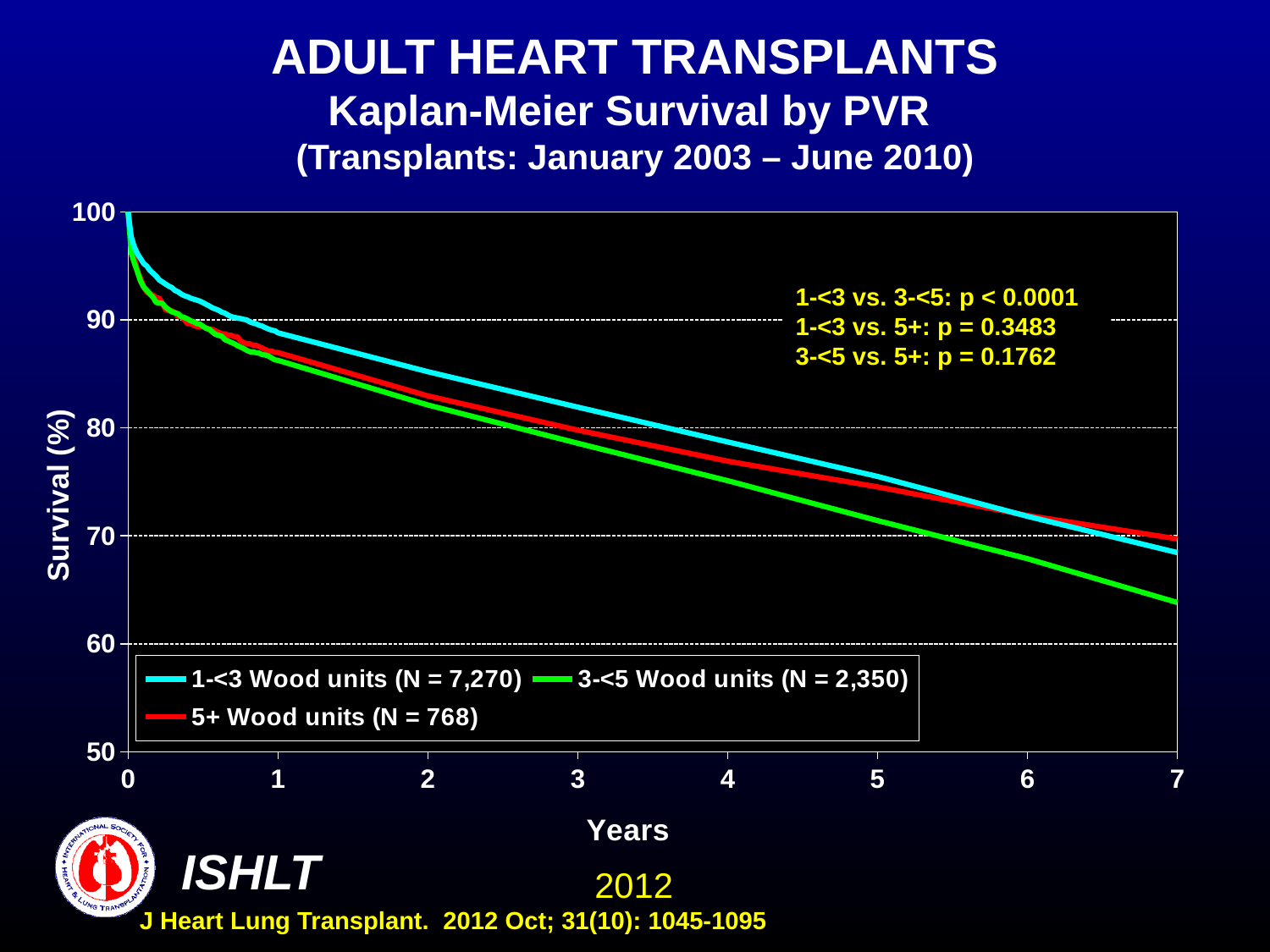
Which series has the lowest survival at 7 years? 3-<5 Wood units Is the survival for 3-<5 Wood units at 7 years greater or less than 70? less At 7 years, is survival higher for 1-<3 Wood units or 3-<5 Wood units? 1-<3 Wood units Do the survival curves rise or fall as years increase? fall What is the N for the 5+ Wood units group shown in the legend? 768 What p-value is shown for the comparison of 1-<3 vs. 3-<5 Wood units? p < 0.0001 Which series has the highest survival at 3 years? 1-<3 Wood units How many series does the legend list? 3 What kind of chart is shown on the slide? line chart Is the survival for 1-<3 Wood units at 2 years greater or less than 80? greater Is the survival for 3-<5 Wood units at 5 years greater or less than 70? greater